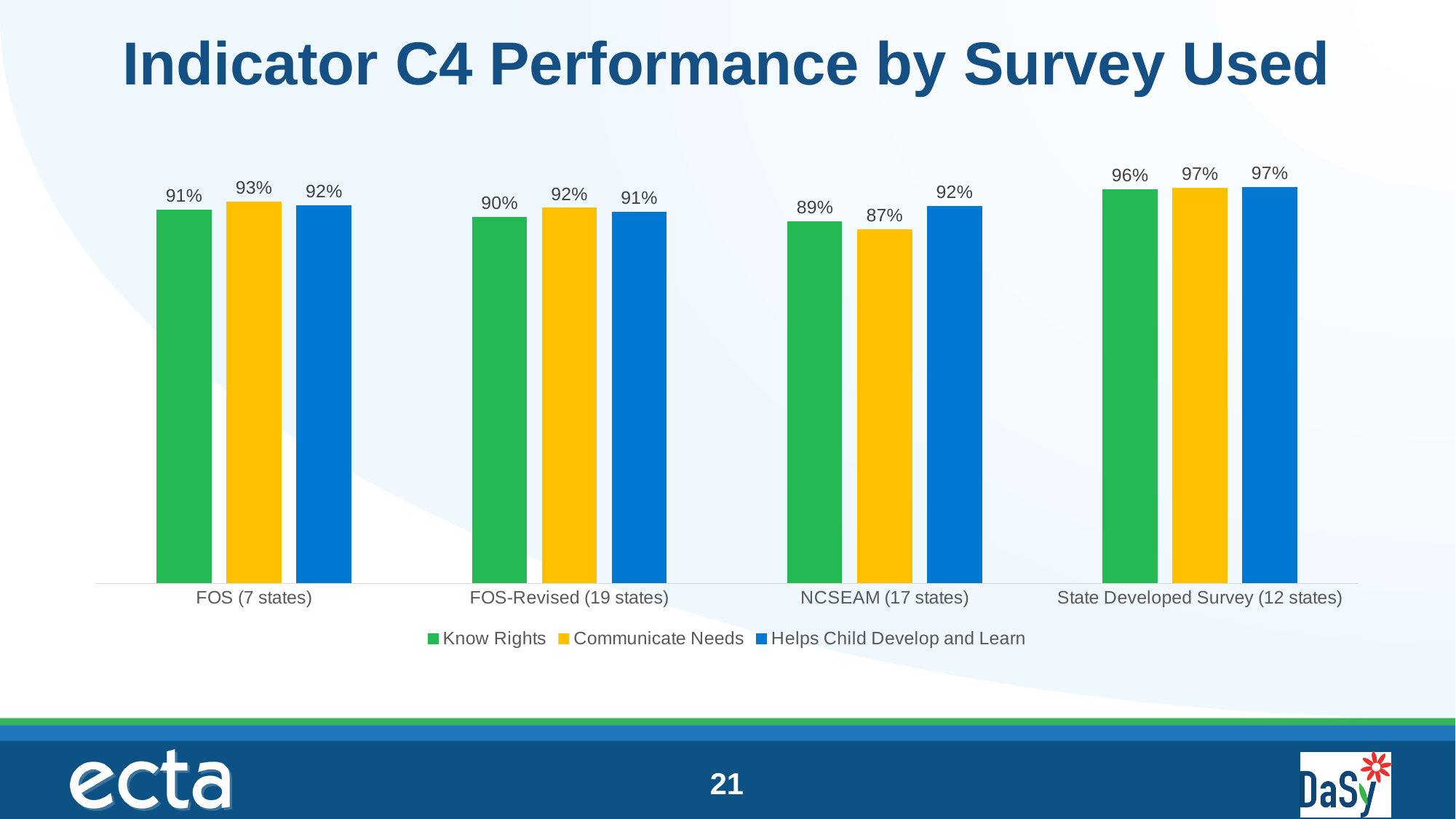
What is the Know Rights value for FOS (7 states)? 91% What is the difference between the Know Rights values for State Developed Survey (12 states) and NCSEAM (17 states)? 7% What is the Communicate Needs value for NCSEAM (17 states)? 87% Which survey has the highest Know Rights value? State Developed Survey (12 states) How many series does the legend list? 3 What is the Helps Child Develop and Learn value for State Developed Survey (12 states)? 97% How many survey categories are shown on the x axis? 4 Which survey has the lowest Communicate Needs value? NCSEAM (17 states) Which is larger: the Communicate Needs value for FOS (7 states) or for NCSEAM (17 states)? FOS (7 states) Which colour represents the Communicate Needs series? Yellow What kind of chart is shown on the slide? Bar chart What is the Communicate Needs value for FOS-Revised (19 states)? 92%